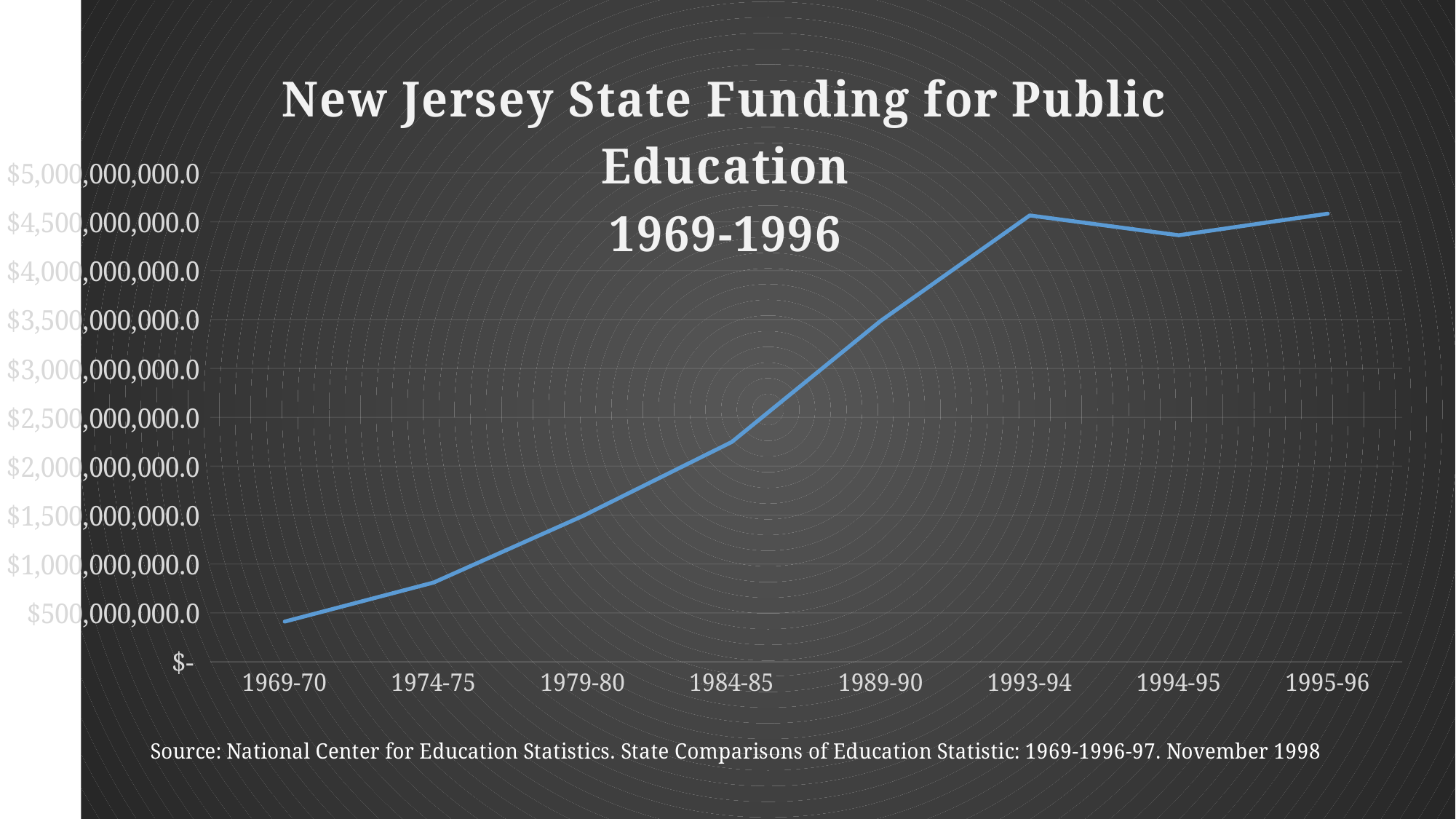
How many school years are plotted on the x axis? 8 Is the value for 1994-95 greater or less than $4,500,000,000.0? less Is the value for 1984-85 greater or less than $2,000,000,000.0? greater Which school year has the lowest state funding? 1969-70 Is the value for 1989-90 greater or less than $3,000,000,000.0? greater What is the title of the chart? New Jersey State Funding for Public Education 1969-1996 Which is larger, the value for 1993-94 or the value for 1994-95? 1993-94 Does state funding generally rise or fall from 1969-70 to 1993-94? rise What kind of chart is shown on the slide? line chart